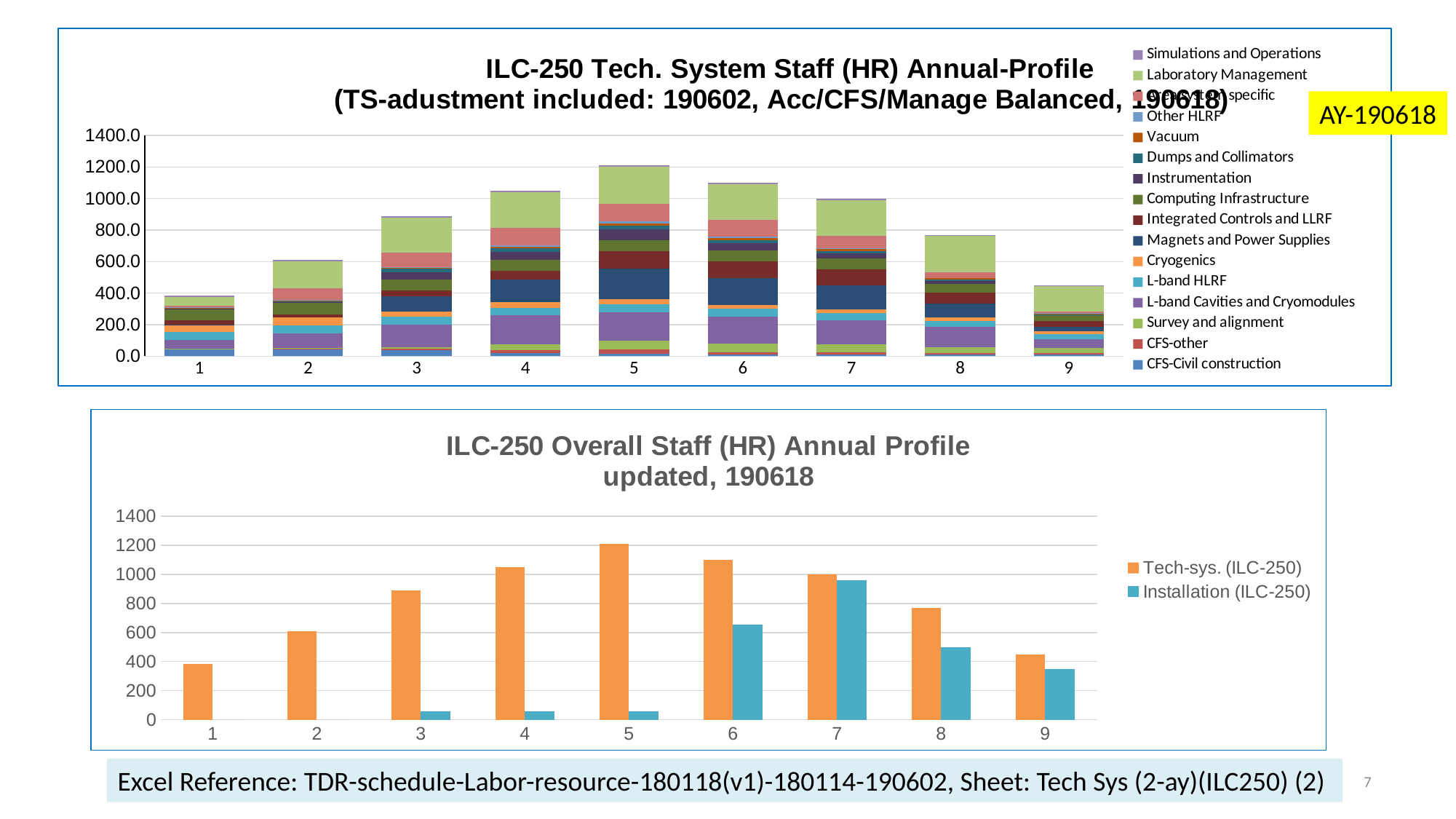
In the bottom chart, for category 6, which is larger: Tech-sys. (ILC-250) or Installation (ILC-250)? Tech-sys. (ILC-250) In the bottom chart, is the Installation (ILC-250) value for category 6 greater or less than 600? greater In the bottom chart, is the Installation (ILC-250) value for category 3 greater or less than 200? less In the bottom chart, which category has the lowest Tech-sys. (ILC-250) value? 1 How many series does the legend of the bottom chart list? 2 In the bottom chart, do the Tech-sys. (ILC-250) values rise or fall from category 5 to category 9? fall How many categories are shown on the x axis of the bottom chart? 9 In the bottom chart, which category has the highest Installation (ILC-250) value? 7 In the bottom chart, which category has the highest Tech-sys. (ILC-250) value? 5 In the bottom chart, is the Tech-sys. (ILC-250) value for category 5 greater or less than 1000? greater In the top chart, 'ILC-250 Tech. System Staff (HR) Annual-Profile', which category has the tallest stacked bar? 5 What kind of chart is the bottom chart, 'ILC-250 Overall Staff (HR) Annual Profile'? bar chart